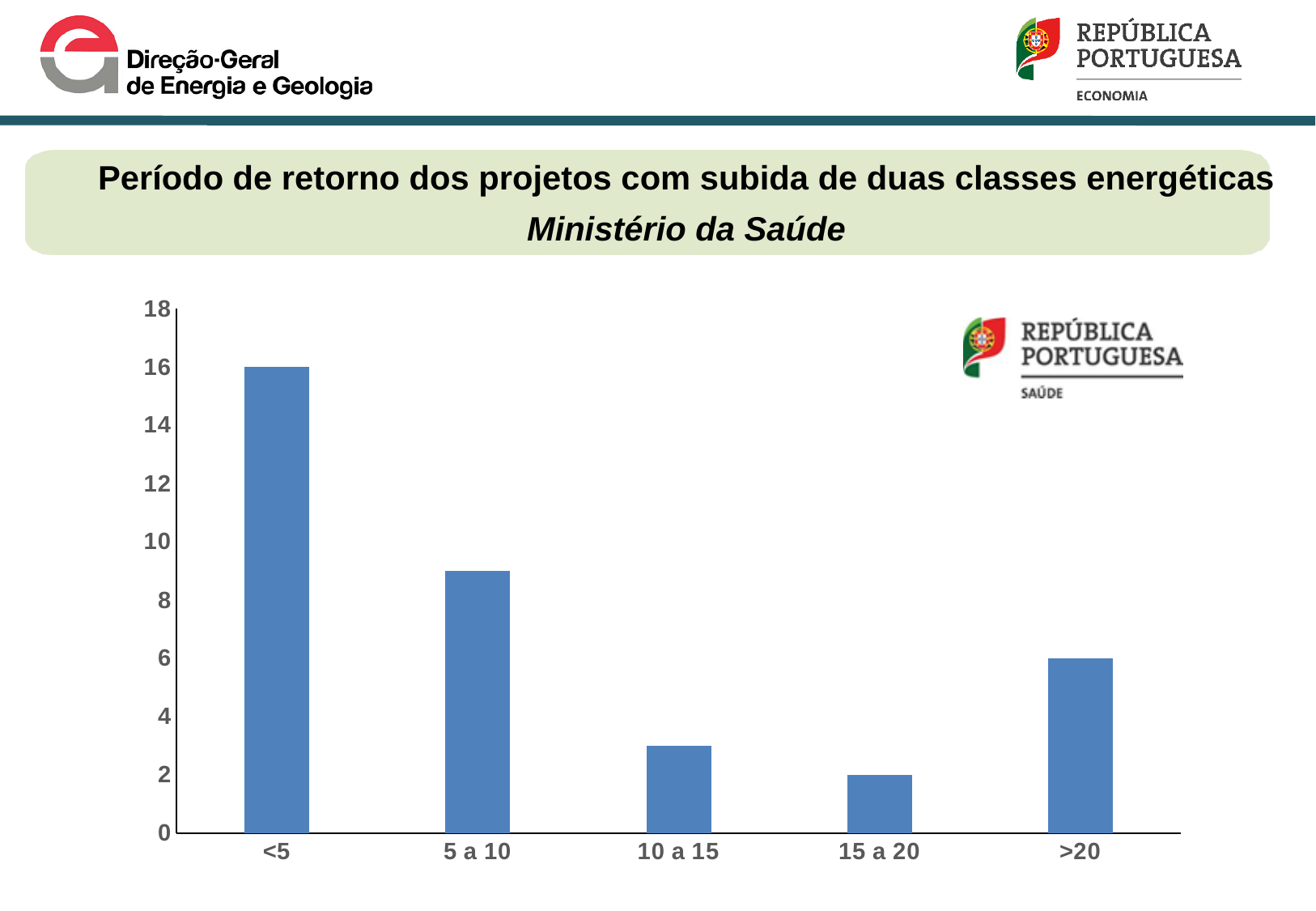
Which category has the lowest value? 15 a 20 What is the value for the <5 category? 16 What is the difference between the values for <5 and >20? 10 Is the value for 5 a 10 greater or less than 8? greater Which category has the highest value? <5 Is the value for 10 a 15 greater or less than 4? less How many categories are shown on the x axis? 5 Which is larger, the value for 5 a 10 or the value for >20? 5 a 10 What kind of chart is shown on the slide? bar chart What is the value for the >20 category? 6 What is the difference between the values for >20 and 15 a 20? 4 What is the value for the 15 a 20 category? 2